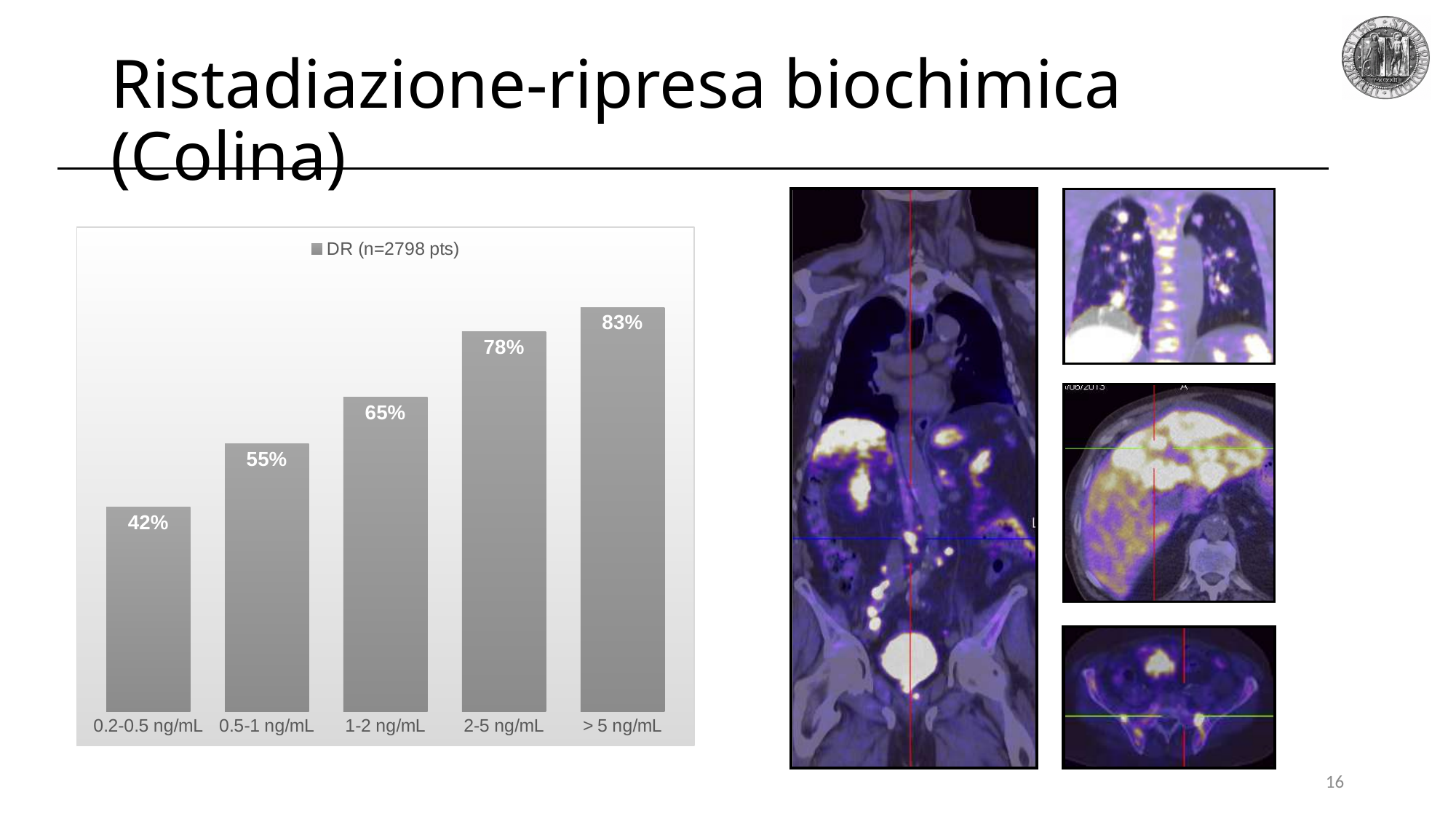
What kind of chart is shown on the slide? Bar chart What is the difference in detection rate between the 2-5 ng/mL and 0.5-1 ng/mL categories? 23% How many series does the chart legend list? 1 What is the detection rate (DR) for the 0.2-0.5 ng/mL category? 42% What is the detection rate (DR) for the > 5 ng/mL category? 83% Which PSA category has the highest detection rate? > 5 ng/mL What is the detection rate (DR) for the 1-2 ng/mL category? 65% What is the legend entry of the chart? DR (n=2798 pts) Do the detection rates rise or fall as the PSA category increases along the x axis? Rise How many PSA categories are shown on the x axis of the chart? 5 Which has a higher detection rate, 0.5-1 ng/mL or 1-2 ng/mL? 1-2 ng/mL Which PSA category has the lowest detection rate? 0.2-0.5 ng/mL